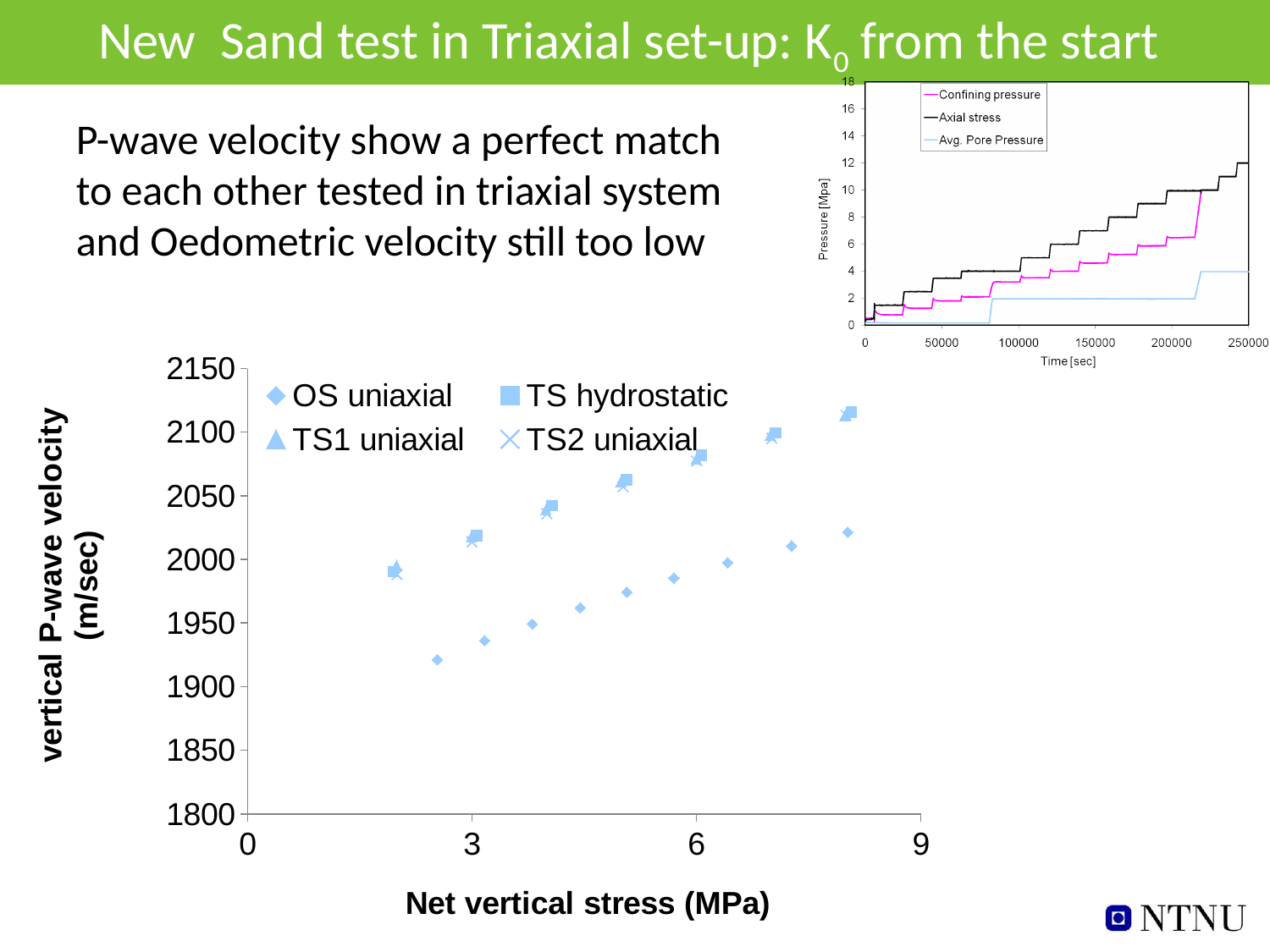
What kind of chart is the large chart at the bottom left of the slide? scatter chart In the small chart at the top right, is the Avg. Pore Pressure at the end of the test (about 250000 sec) greater or less than 6 MPa? less In the large chart at the bottom left, how many series does the legend list? 4 In the large chart at the bottom left, is the OS uniaxial value at the highest stress (about 8 MPa) greater or less than 2000 m/sec? greater In the large chart at the bottom left, is the TS hydrostatic value at the highest stress (about 8 MPa) greater or less than 2100 m/sec? greater In the large chart at the bottom left, do the P-wave velocity values rise or fall as net vertical stress increases? rise What is the x-axis title of the large chart at the bottom left? Net vertical stress (MPa) In the small chart at the top right, how many series does the legend list? 3 What kind of chart is the small chart at the top right of the slide? line chart In the small chart at the top right, which series reaches the highest pressure? Axial stress In the large chart at the bottom left, at a net vertical stress of about 8 MPa, which series has the higher velocity: OS uniaxial or TS hydrostatic? TS hydrostatic